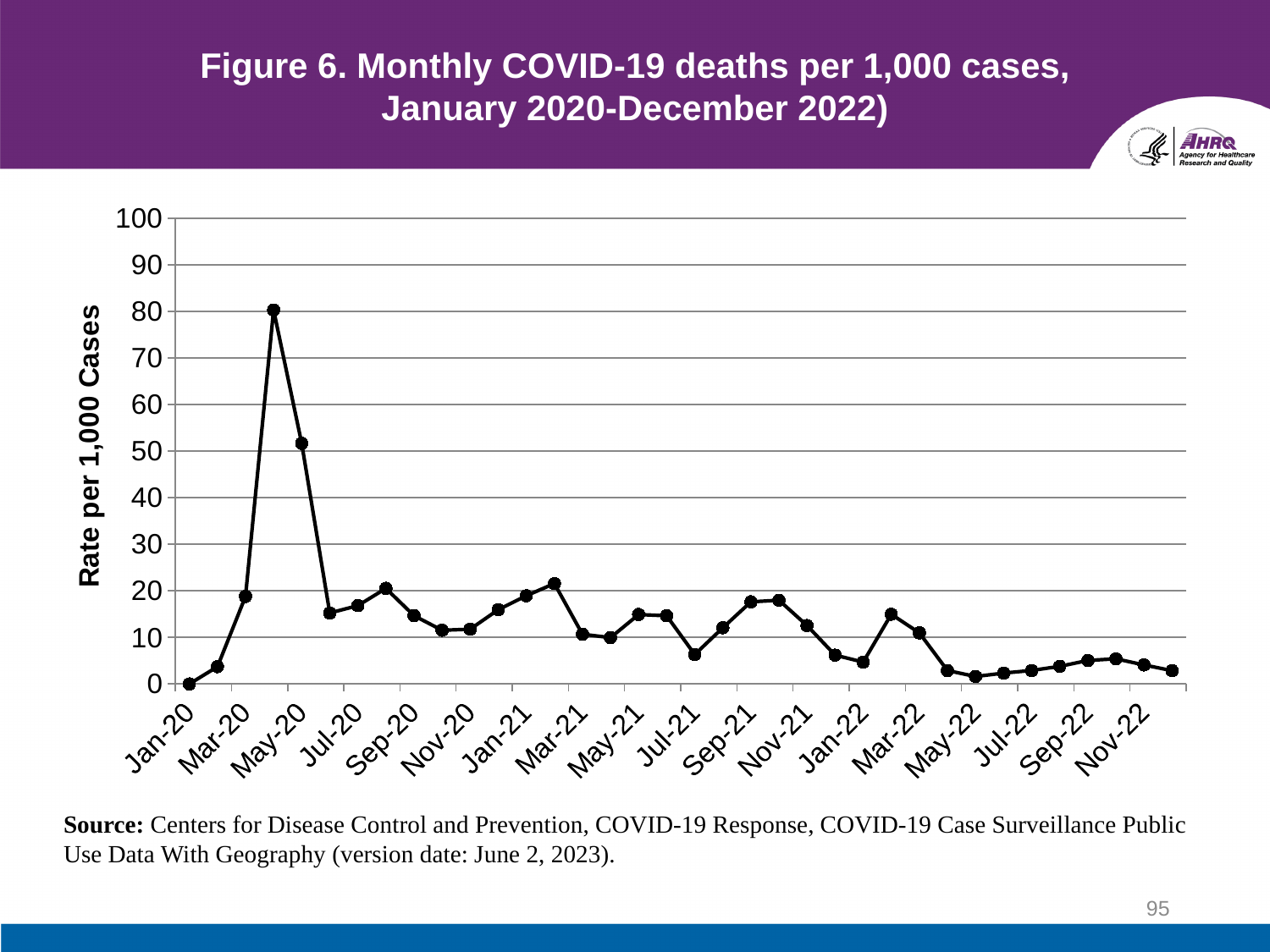
Is the value for May-20 greater or less than 40? greater Between Jan-20 and Mar-20, does the rate rise or fall? Rise What is the title of the y axis? Rate per 1,000 Cases Is the value for Nov-21 greater or less than 10? greater Which is larger, the value for May-20 or the value for Jul-20? May-20 How many month labels are shown along the x axis? 18 Is the highest point on the line greater or less than 70? greater Which is larger, the value for Jan-22 or the value for Mar-22? Mar-22 What kind of chart is shown on the slide? Line chart